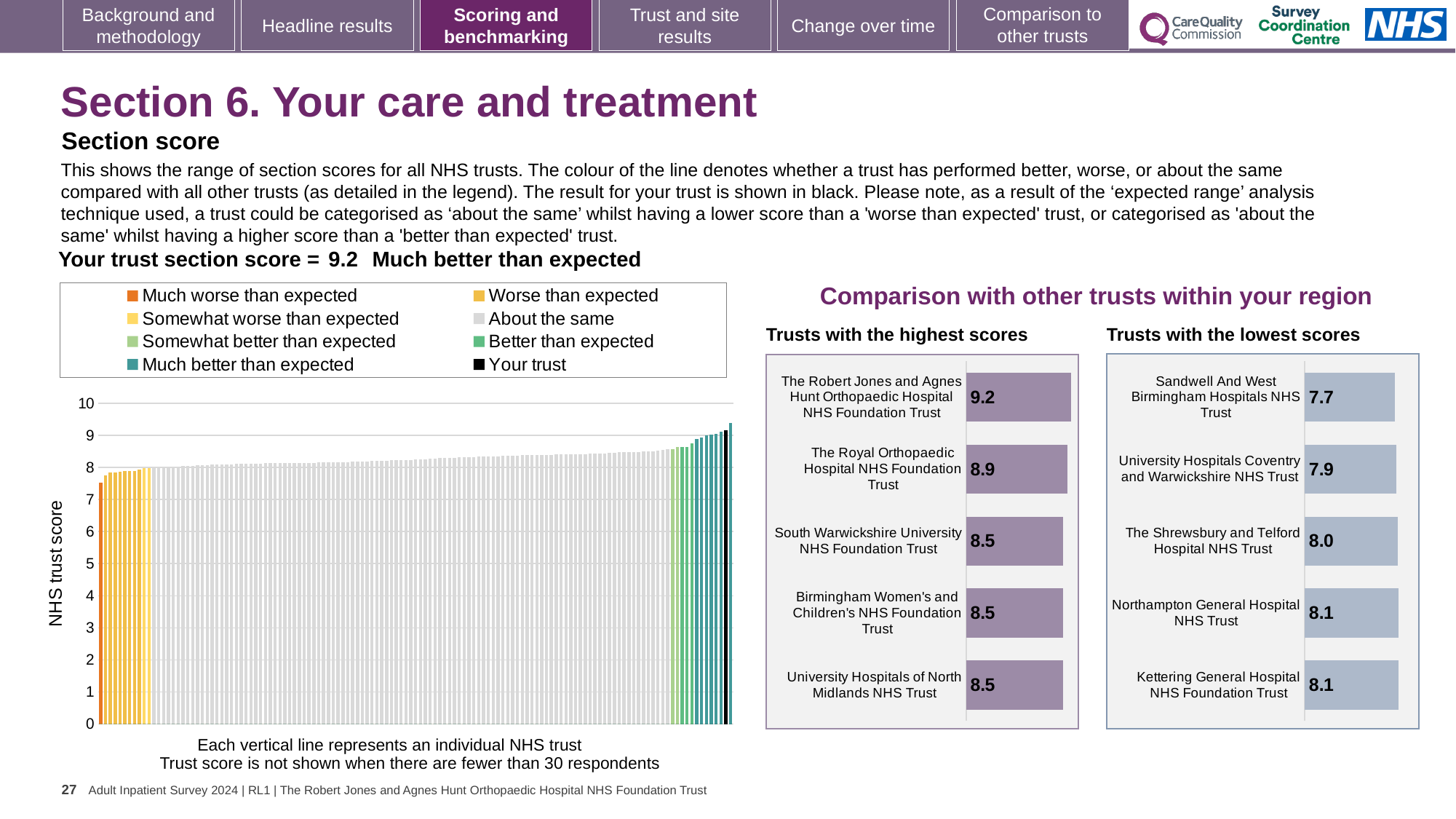
In the 'Trusts with the lowest scores' chart, what is the difference between the scores of Northampton General Hospital NHS Trust and Sandwell And West Birmingham Hospitals NHS Trust? 0.4 In the 'Trusts with the lowest scores' chart, which has the higher score: University Hospitals Coventry and Warwickshire NHS Trust or Kettering General Hospital NHS Foundation Trust? Kettering General Hospital NHS Foundation Trust How many trusts are shown in the 'Trusts with the highest scores' chart? 5 In the 'Trusts with the highest scores' chart, what is the difference between the scores of The Robert Jones and Agnes Hunt Orthopaedic Hospital NHS Foundation Trust and South Warwickshire University NHS Foundation Trust? 0.7 What kind of chart is the 'Trusts with the lowest scores' chart? Bar chart In the main 'NHS trust score' chart, is the value of the lowest (leftmost) bar greater or less than 8? less In the main 'NHS trust score' chart, what colour represents 'Your trust' in the legend? Black In the 'Trusts with the highest scores' chart, what is the score for The Royal Orthopaedic Hospital NHS Foundation Trust? 8.9 In the 'Trusts with the lowest scores' chart, which trust has the lowest score? Sandwell And West Birmingham Hospitals NHS Trust In the 'Trusts with the highest scores' chart, which trust has the highest score? The Robert Jones and Agnes Hunt Orthopaedic Hospital NHS Foundation Trust In the 'Trusts with the lowest scores' chart, what is the score for The Shrewsbury and Telford Hospital NHS Trust? 8.0 How many entries does the legend of the main 'NHS trust score' chart list? 8